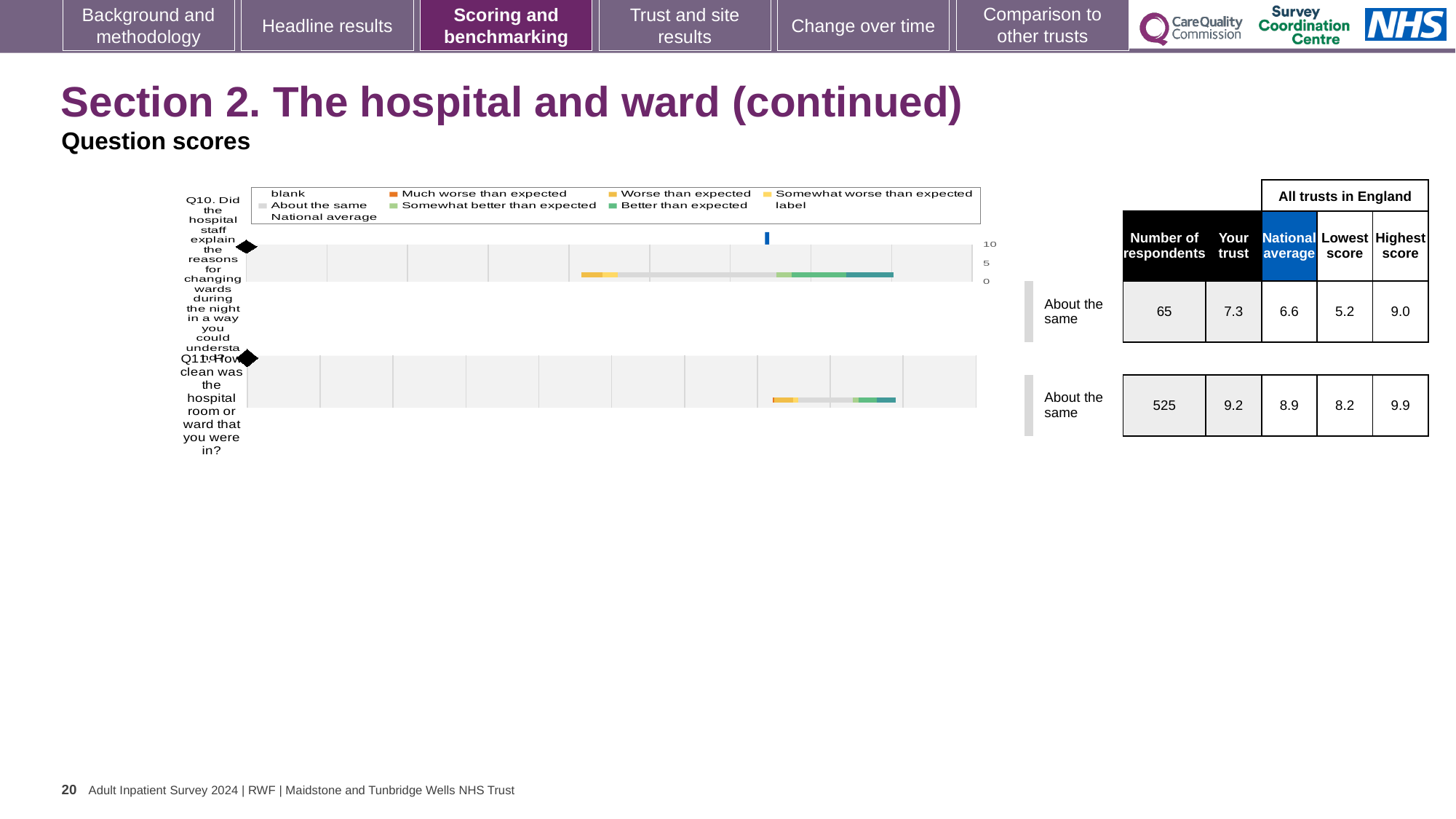
What benchmark category is shown for Q11 (how clean was the hospital room or ward)? About the same How many questions are plotted on this slide? 2 For Q11 (how clean was the hospital room or ward), what is the highest score among all trusts in England? 9.9 For Q11 (how clean was the hospital room or ward), what is the national average score? 8.9 How many respondents answered Q11 (how clean was the hospital room or ward)? 525 For Q11 (how clean was the hospital room or ward), what is the score for your trust? 9.2 For Q10 (explaining reasons for changing wards during the night), what is the difference between the highest and lowest scores among all trusts in England? 3.8 For Q10 (explaining reasons for changing wards during the night), what is the difference between your trust's score and the national average? 0.7 For Q11 (how clean was the hospital room or ward), which is higher: your trust's score or the national average? Your trust For Q10 (explaining reasons for changing wards during the night), what is the national average score? 6.6 How many respondents answered Q10 (explaining reasons for changing wards during the night)? 65 For Q10 (explaining reasons for changing wards during the night), what is the score for your trust? 7.3